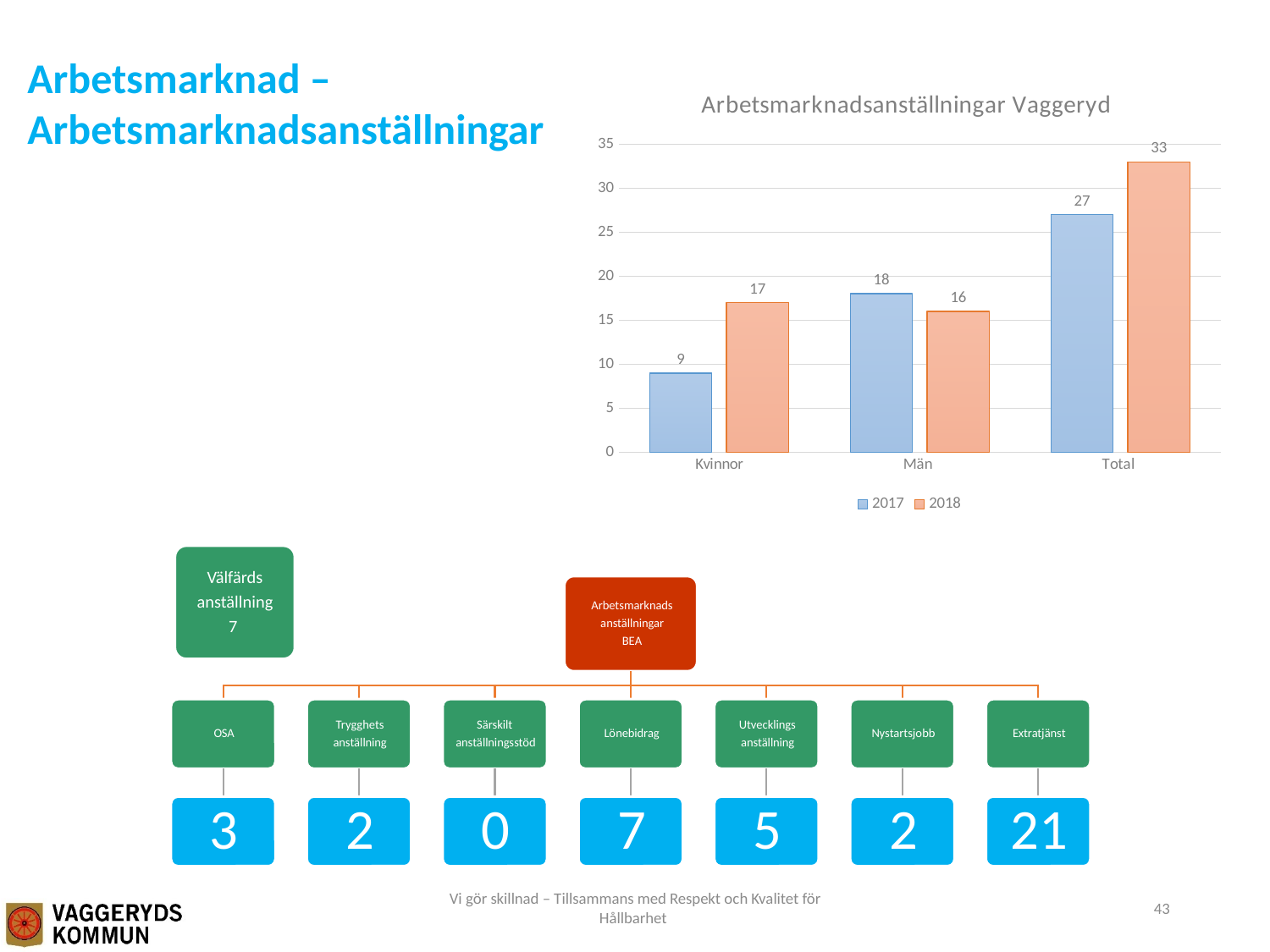
Which category has the lowest value in the 2018 series? Män What is the difference between the 2018 and 2017 values for Kvinnor? 8 What kind of chart is shown? bar chart How many series does the legend list? 2 Which is larger for Män: the 2017 value or the 2018 value? 2017 What is the title of the chart? Arbetsmarknadsanställningar Vaggeryd Is the Total value for 2017 greater or less than 25? greater What is the Total value for 2018? 33 How many categories are shown on the x axis? 3 What is the value for Kvinnor in 2017? 9 What is the value for Män in 2018? 16 Which category has the highest value in the 2017 series? Total